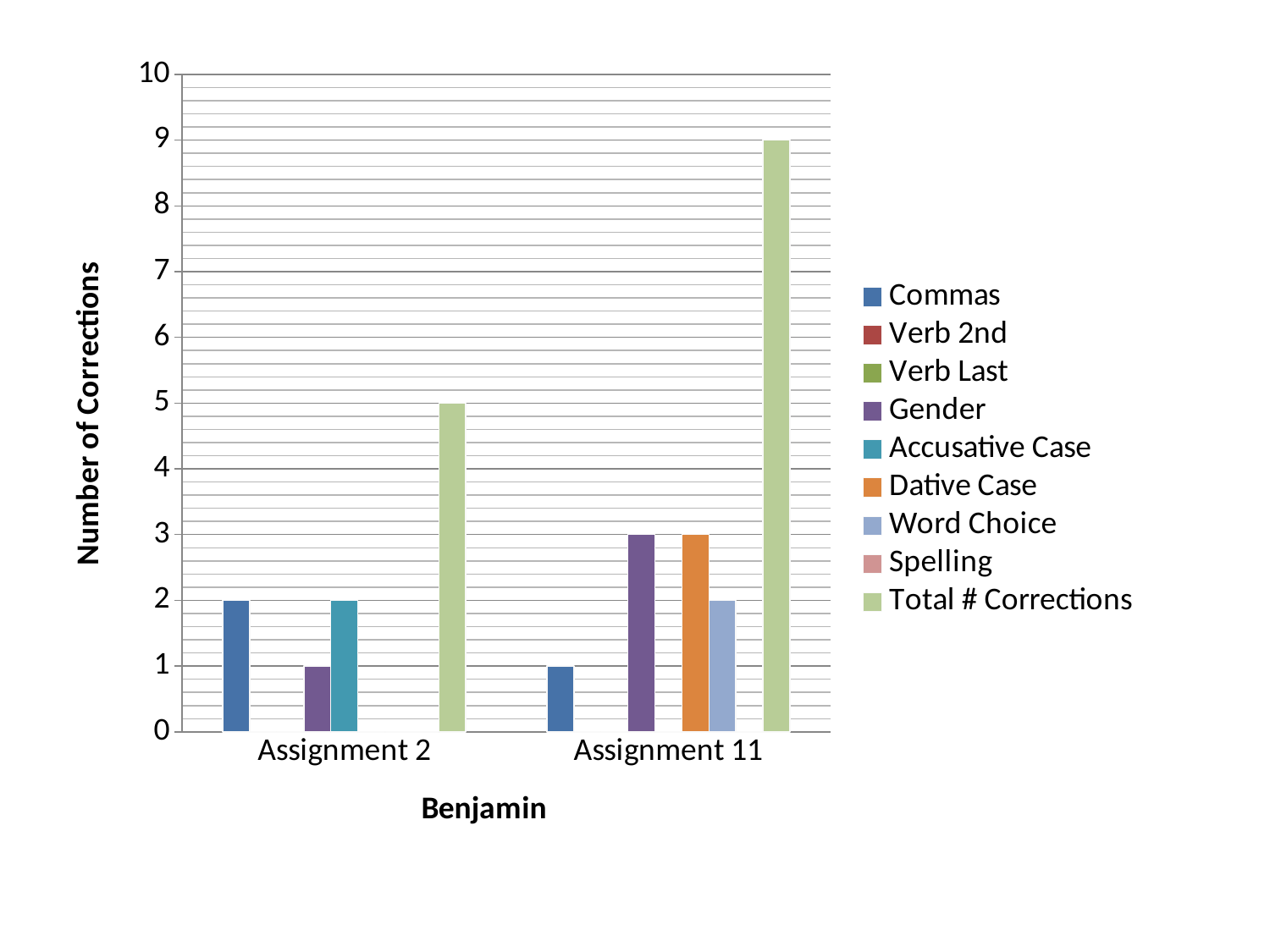
What is the difference in Total # Corrections between Assignment 11 and Assignment 2? 4 What is the label of the y axis? Number of Corrections What is the Total # Corrections value for Assignment 2? 5 How many series does the legend list? 9 Does the Total # Corrections for Assignment 11 rise or fall compared with Assignment 2? rise How many Commas corrections are shown for Assignment 2? 2 How many Gender corrections are shown for Assignment 11? 3 What is the Total # Corrections value for Assignment 11? 9 What kind of chart is shown on the slide? bar chart How many Word Choice corrections are shown for Assignment 11? 2 Which assignment has the higher Total # Corrections? Assignment 11 How many assignment categories are shown on the x axis? 2